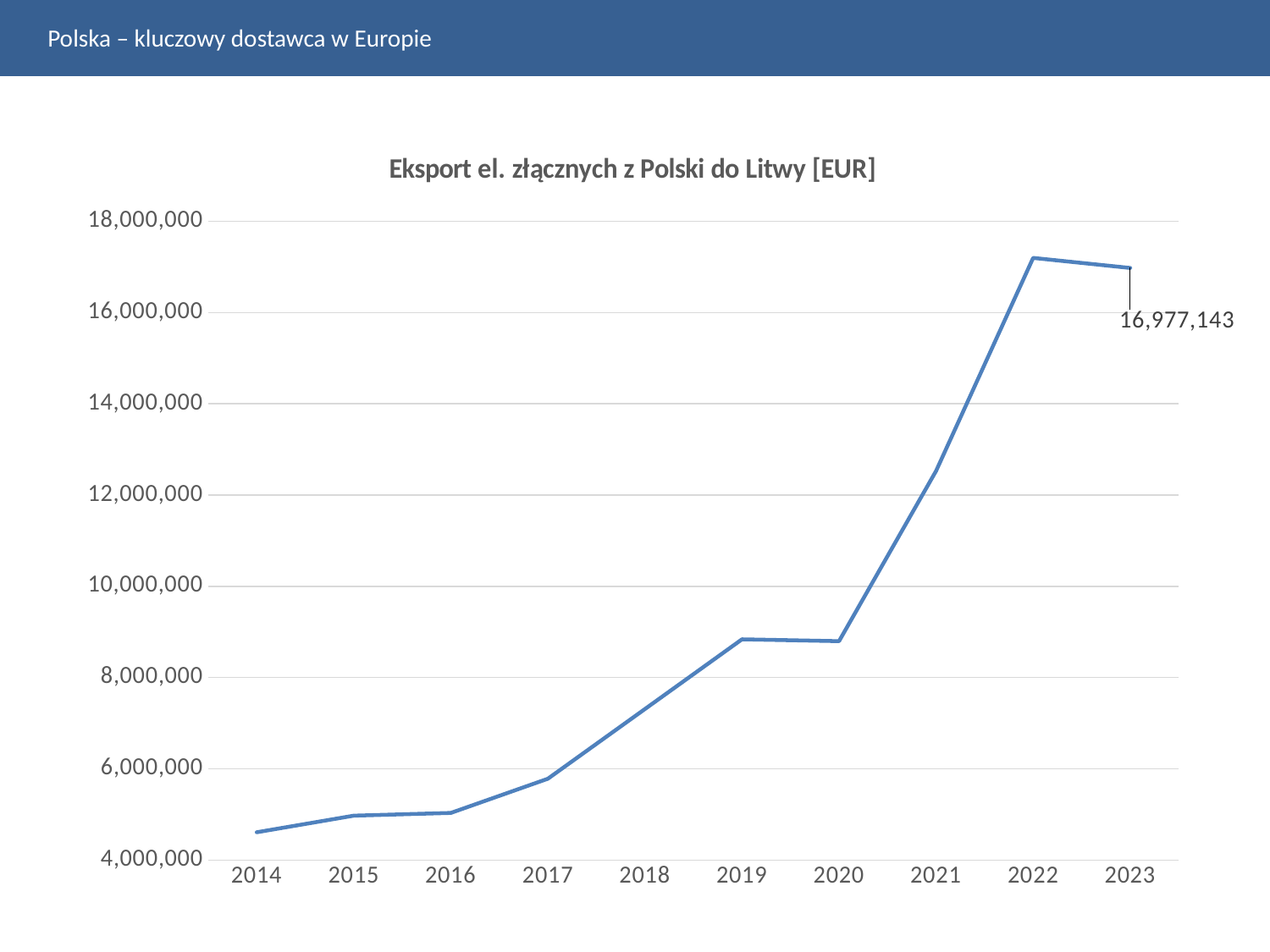
What is the value for 2023? 16,977,143 Which year has the lowest value? 2014 Which year has the highest value? 2022 Do the values generally rise or fall from 2014 to 2022? rise What kind of chart is shown? line chart Is the value for 2017 greater or less than 6,000,000? less Which is larger, the value for 2021 or the value for 2020? 2021 What is the title of the chart? Eksport el. złącznych z Polski do Litwy [EUR] Is the value for 2019 greater or less than 10,000,000? less How many years are plotted on the x axis? 10 Is the value for 2021 greater or less than 12,000,000? greater